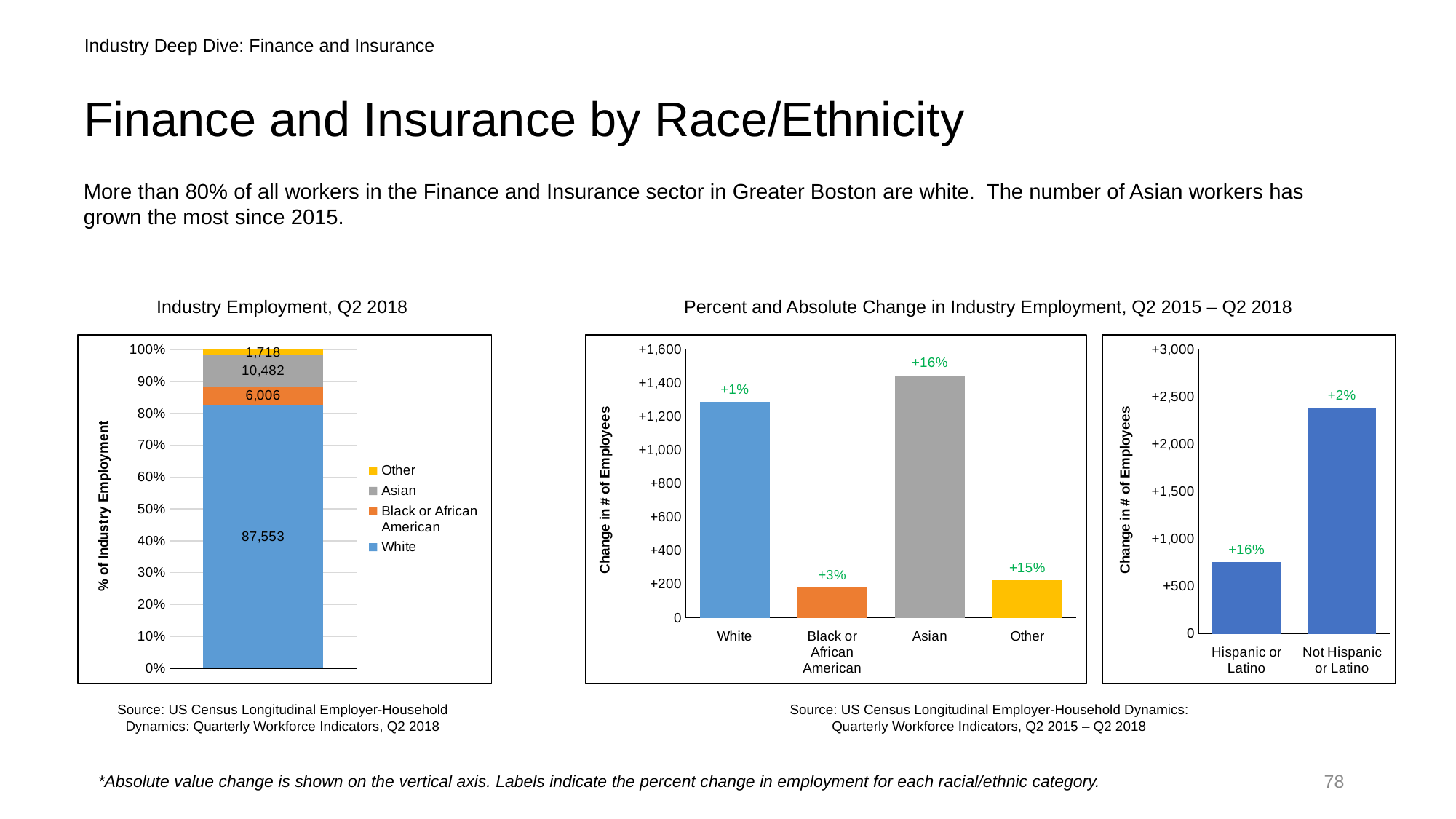
In the right-hand chart (change by Hispanic or Latino status), what percent change label is shown for Not Hispanic or Latino? +2% In the middle chart (Percent and Absolute Change in Industry Employment by race), is the change in number of employees for White greater or less than +1,200? greater In the Industry Employment, Q2 2018 chart, which group has the smallest number of employees? Other In the Industry Employment, Q2 2018 chart, how many White employees are shown? 87,553 In the Industry Employment, Q2 2018 chart, what is the difference between the Asian and Black or African American values? 4,476 In the right-hand chart (change by Hispanic or Latino status), is the change in number of employees for Hispanic or Latino greater or less than +1,000? less In the Industry Employment, Q2 2018 chart, what is the value for Black or African American employees? 6,006 In the middle chart (Percent and Absolute Change in Industry Employment by race), what percent change label is shown for Asian? +16% In the Industry Employment, Q2 2018 chart, what is the total of the stacked bar? 105,759 How many series does the legend of the Industry Employment, Q2 2018 chart list? 4 In the Industry Employment, Q2 2018 chart, what is the value for Asian employees? 10,482 In the middle chart (Percent and Absolute Change in Industry Employment by race), which category has the largest absolute change in number of employees? Asian